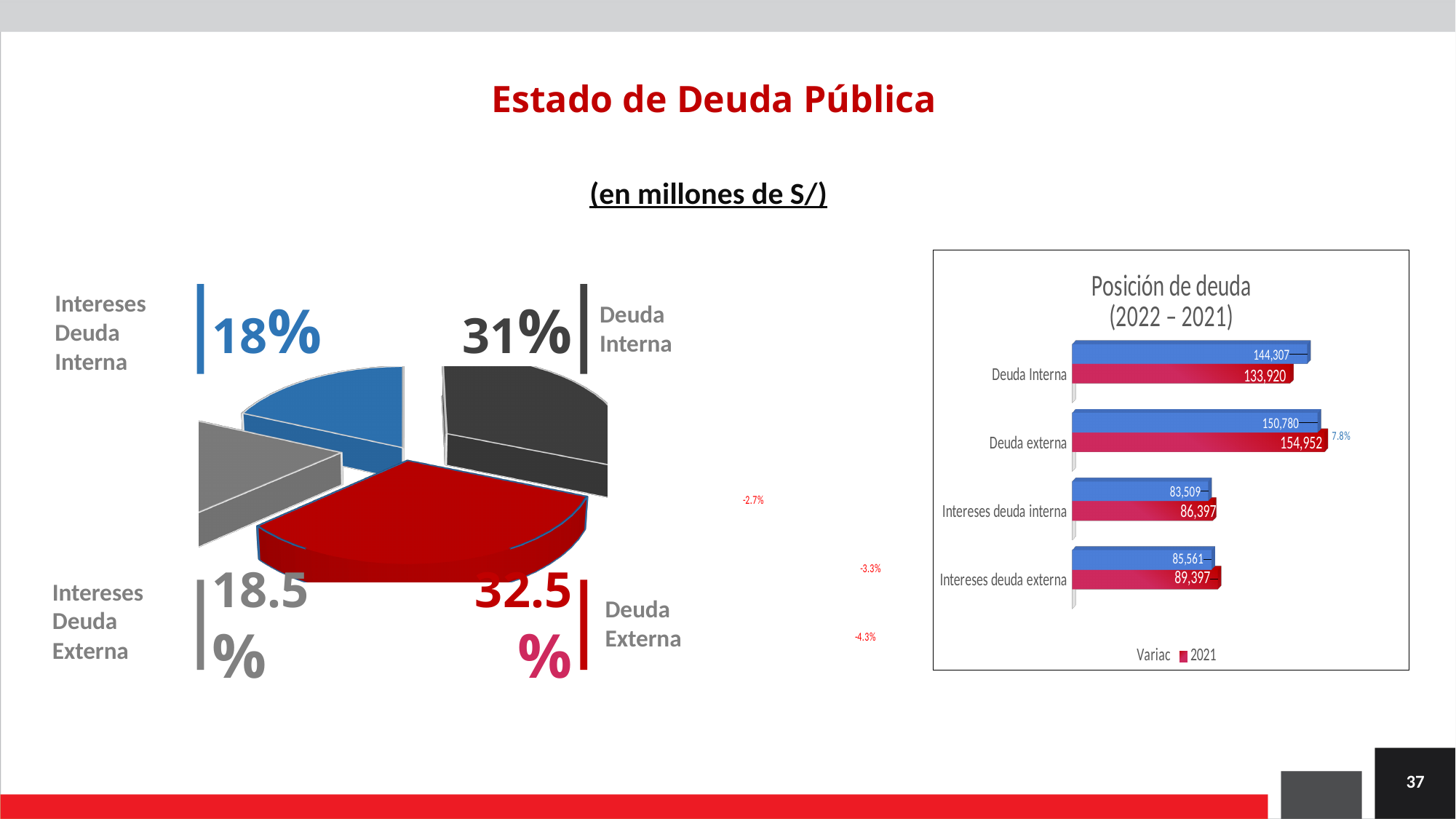
What kind of chart is the chart on the left of the slide? Pie chart How many slices does the pie chart on the left have? 4 In the pie chart on the left, which category has the largest share? Deuda Externa What kind of chart is 'Posición de deuda (2022 – 2021)'? Bar chart How many categories are shown in the 'Posición de deuda (2022 – 2021)' chart? 4 In the 'Posición de deuda (2022 – 2021)' chart, what is the difference between the blue bar and the red bar for Deuda Interna? 10,387 In the pie chart on the left, what share does Intereses Deuda Interna represent? 18% In the pie chart on the left, what share does Deuda Externa represent? 32.5% In the 'Posición de deuda (2022 – 2021)' chart, what is the value of the blue bar for Deuda Interna? 144,307 In the pie chart on the left, which category has the smallest share? Intereses Deuda Interna In the 'Posición de deuda (2022 – 2021)' chart, which is larger for Intereses deuda externa, the blue bar or the red bar? The red bar In the 'Posición de deuda (2022 – 2021)' chart, what is the value of the red bar for Deuda externa? 154,952